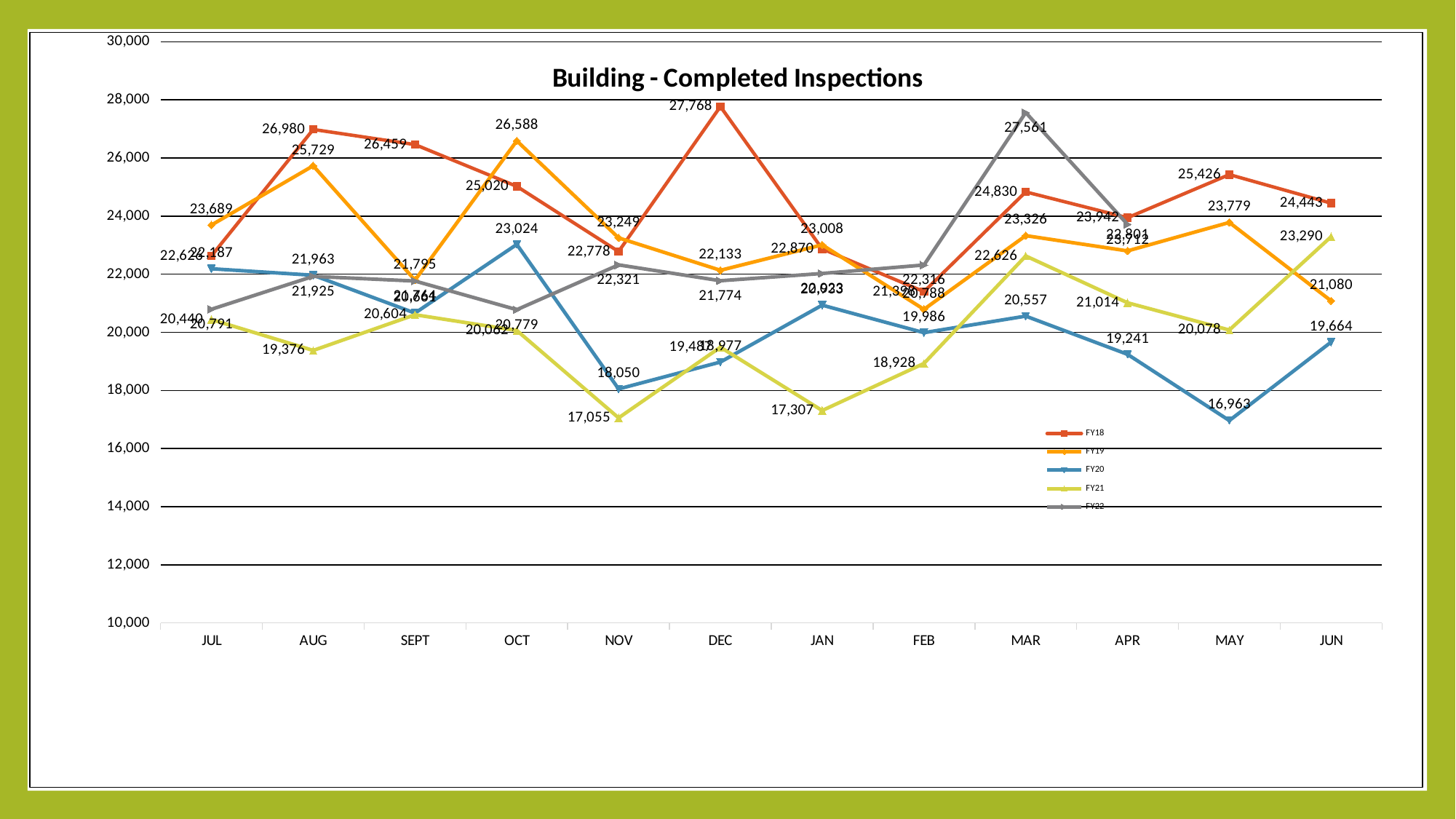
In which month is the FY20 value lowest? MAY Is the FY21 value for NOV greater or less than 18,000? less What kind of chart is shown on the slide? line chart What is the FY19 value for OCT? 26,588 What is the difference between the FY18 and FY19 values for DEC? 5,635 What is the FY20 value for MAY? 16,963 What is the FY18 value for DEC? 27,768 In which month is the FY18 value highest? DEC How many series does the legend list? 5 What is the FY22 value for MAR? 27,561 How many months are shown on the x axis? 12 Which is larger in NOV, the FY18 value or the FY20 value? FY18